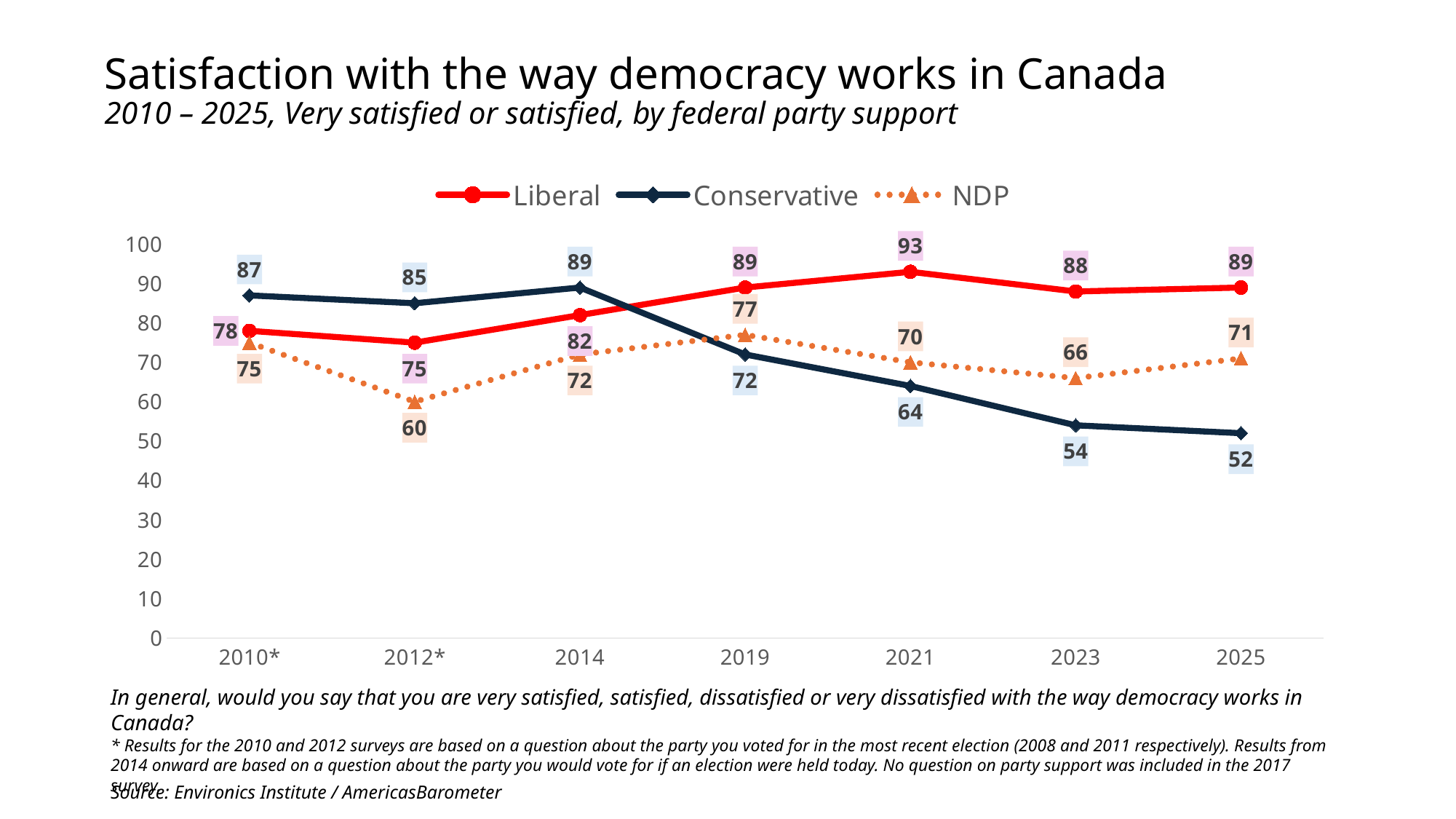
Which is larger in 2014, the Liberal value or the Conservative value? Conservative What is the NDP value in 2012*? 60 What is the Liberal value in 2021? 93 In which year is the Liberal series highest? 2021 How many years are shown on the x axis? 7 What is the Conservative value in 2025? 52 In which year is the Conservative series lowest? 2025 What is the difference between the Liberal and Conservative values in 2025? 37 Does the Conservative series rise or fall from 2014 to 2025? Fall Which series is drawn with a dotted line? NDP How many series does the legend list? 3 What kind of chart is this? Line chart